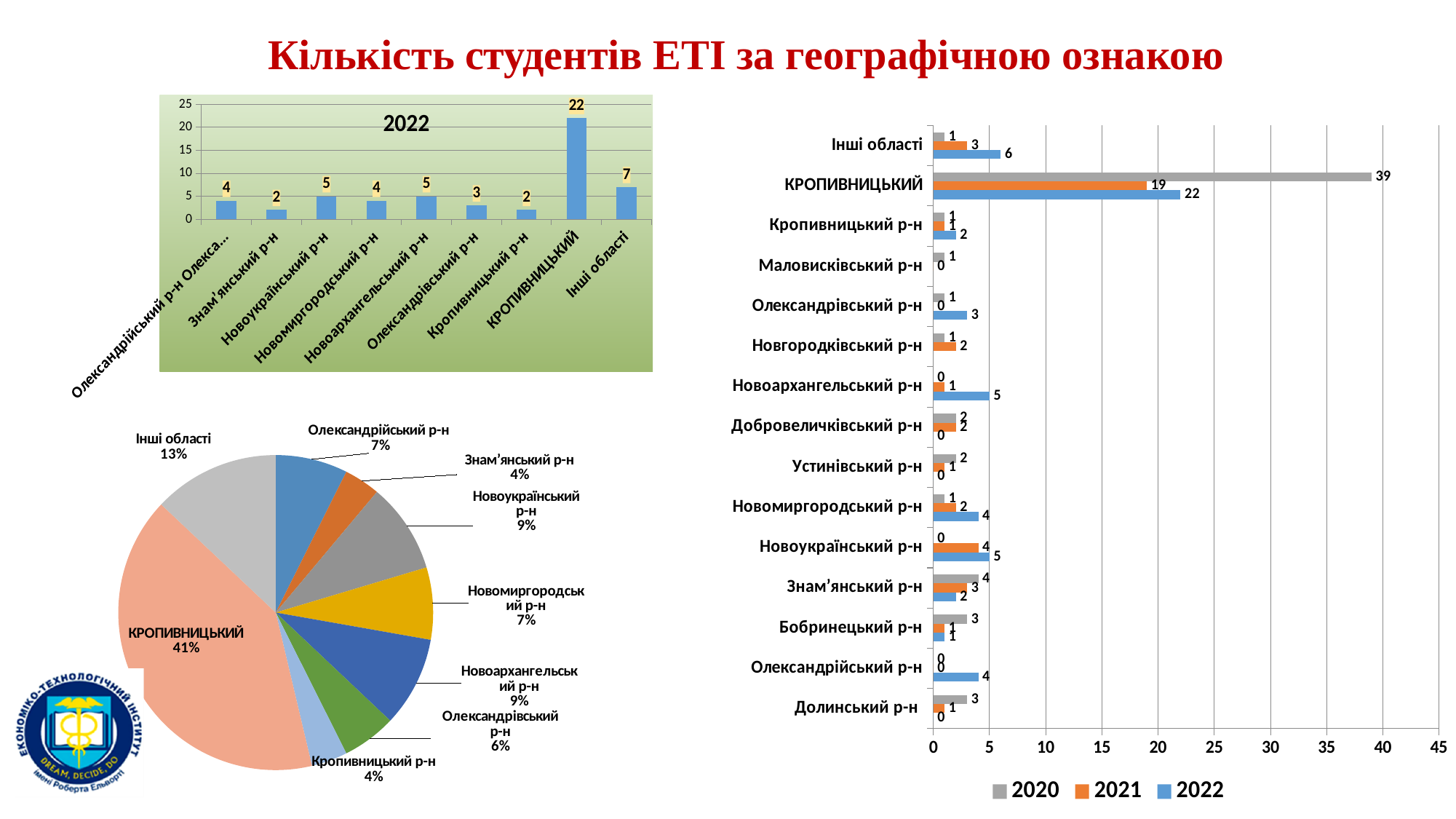
In the right-hand bar chart, what is the 2022 value for Інші області? 6 In the bottom-left pie chart, what share does Інші області have? 13% In the bottom-left pie chart, which is larger, Новоукраїнський р-н or Олександрівський р-н? Новоукраїнський р-н In the right-hand bar chart, what is the difference between the 2020 and 2021 values for КРОПИВНИЦЬКИЙ? 20 In the right-hand bar chart, what is the 2020 value for КРОПИВНИЦЬКИЙ? 39 In the right-hand bar chart, how many series does the legend list? 3 In the bottom-left pie chart, what share does КРОПИВНИЦЬКИЙ have? 41% In the top-left bar chart titled 2022, what is the difference between the values for Інші області and Знам'янський р-н? 5 What kind of chart is the bottom-left chart? Pie chart In the top-left bar chart titled 2022, what is the value for КРОПИВНИЦЬКИЙ? 22 In the top-left bar chart titled 2022, which category has the highest value? КРОПИВНИЦЬКИЙ In the top-left bar chart titled 2022, how many categories are shown? 9